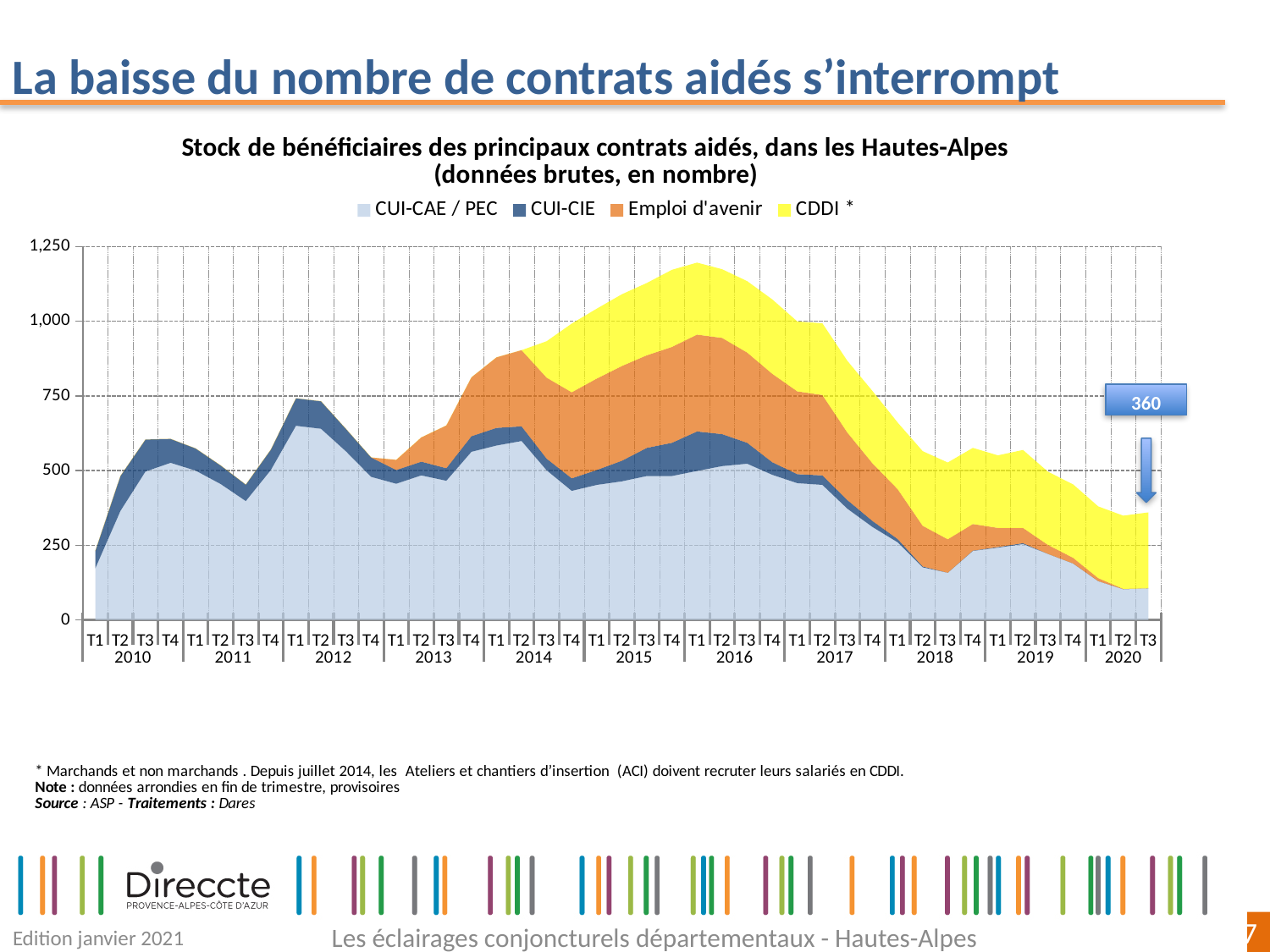
In which year does the total stock reach its highest level? 2016 What is the title of the chart? Stock de bénéficiaires des principaux contrats aidés, dans les Hautes-Alpes (données brutes, en nombre) What total stock value is labelled for T3 2020? 360 How many series does the legend list? 4 Is the total stock at T1 2010 greater or less than 500? less Is the total stock at T1 2016 greater or less than 1,000? greater What kind of chart is shown on the slide? stacked area chart Is the total stock at T1 2020 greater or less than 500? less How many years are shown on the x axis? 11 Does the total stock rise or fall between T1 2016 and T3 2020? fall How many quarters are shown for 2020? 3 Which colour represents the CDDI * series? yellow